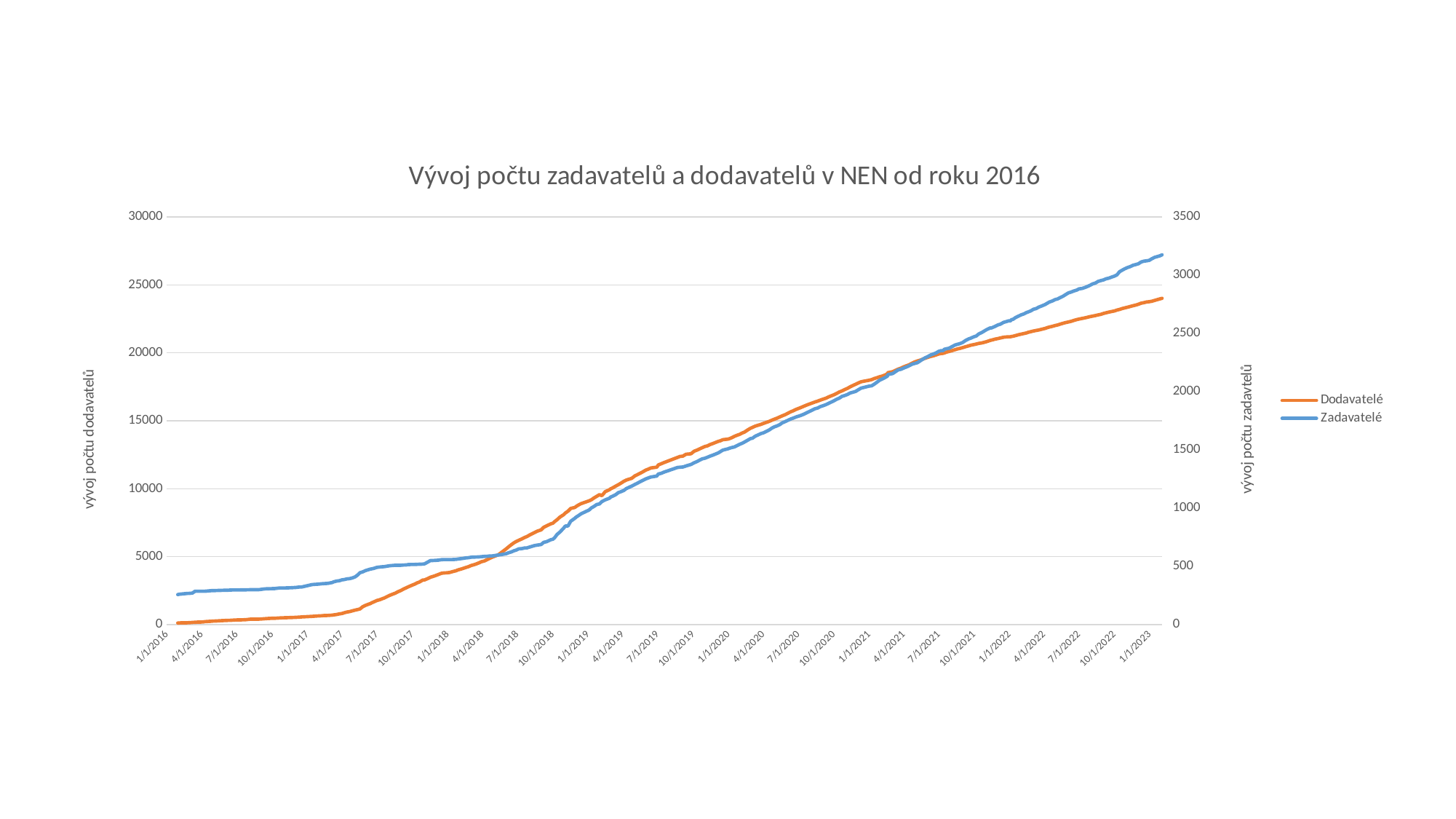
How many series does the legend list? 2 Is the value for Dodavatelé at 1/1/2021 (left axis) greater or less than 15000? greater What is the title of the chart? Vývoj počtu zadavatelů a dodavatelů v NEN od roku 2016 Is the value for Zadavatelé at 1/1/2023 (right axis) greater or less than 3000? greater Is the value for Dodavatelé at 1/1/2023 (left axis) greater or less than 25000? less Do the values for Zadavatelé rise or fall from 1/1/2016 to 1/1/2023? rise Which series is drawn in orange? Dodavatelé Do the values for Dodavatelé rise or fall from 1/1/2016 to 1/1/2023? rise What kind of chart is shown on the slide? line chart